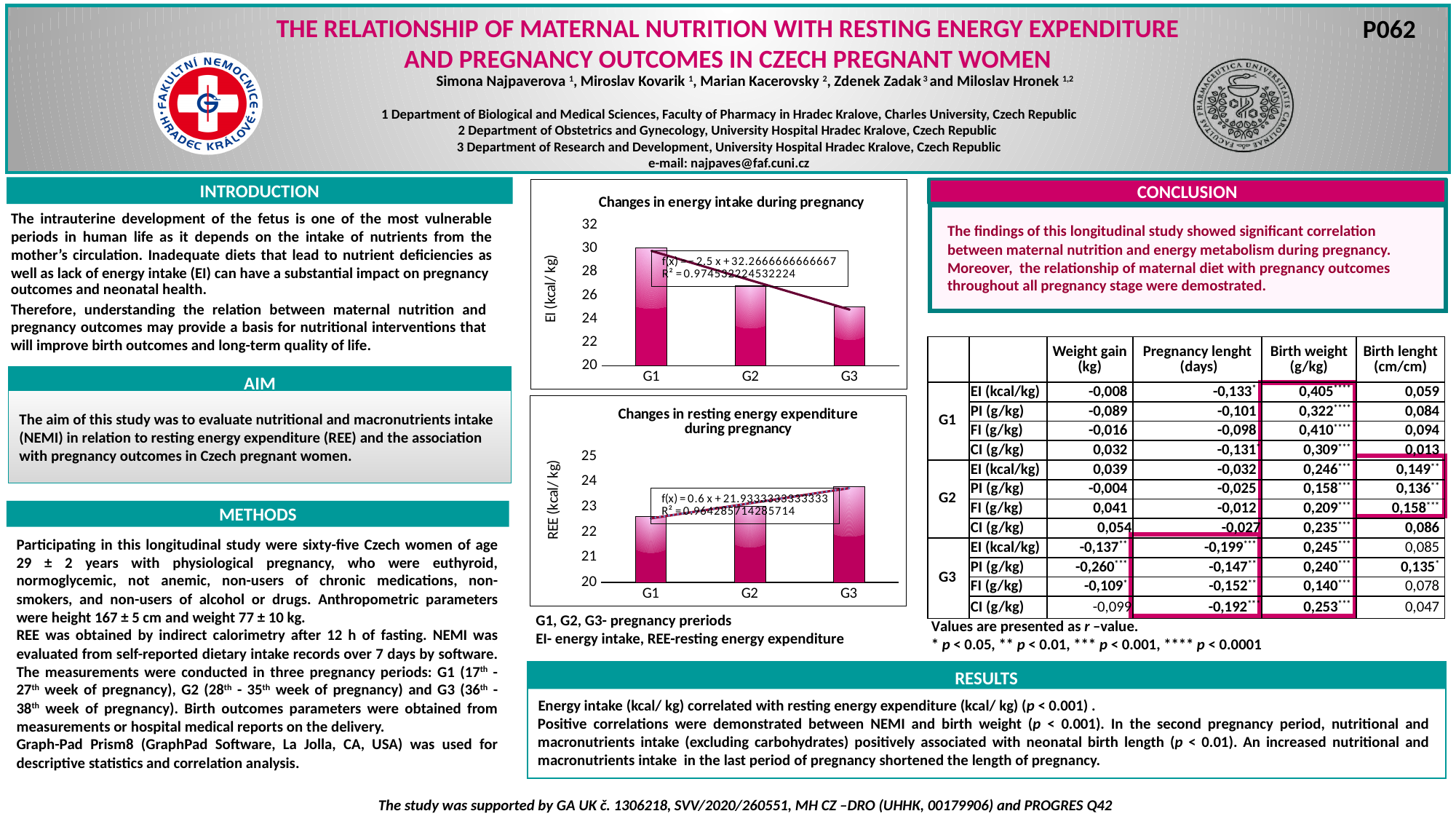
In the "Changes in resting energy expenditure during pregnancy" chart, is the value for G1 greater or less than 23? less What is the y-axis label of the "Changes in resting energy expenditure during pregnancy" chart? REE (kcal/ kg) In the "Changes in energy intake during pregnancy" chart, which period has the lowest energy intake? G3 In the "Changes in resting energy expenditure during pregnancy" chart, do the values rise or fall from G1 to G3? rise In the "Changes in energy intake during pregnancy" chart, is the value for G3 greater or less than 26? less In the "Changes in energy intake during pregnancy" chart, do the values rise or fall from G1 to G3? fall In the "Changes in resting energy expenditure during pregnancy" chart, which period has the lowest REE? G1 In the "Changes in energy intake during pregnancy" chart, which period has the highest energy intake? G1 In the "Changes in resting energy expenditure during pregnancy" chart, which is larger, the value for G1 or G3? G3 In the "Changes in energy intake during pregnancy" chart, is the value for G1 greater or less than 28? greater How many pregnancy periods are plotted in the "Changes in energy intake during pregnancy" chart? 3 What kind of chart is "Changes in energy intake during pregnancy"? bar chart